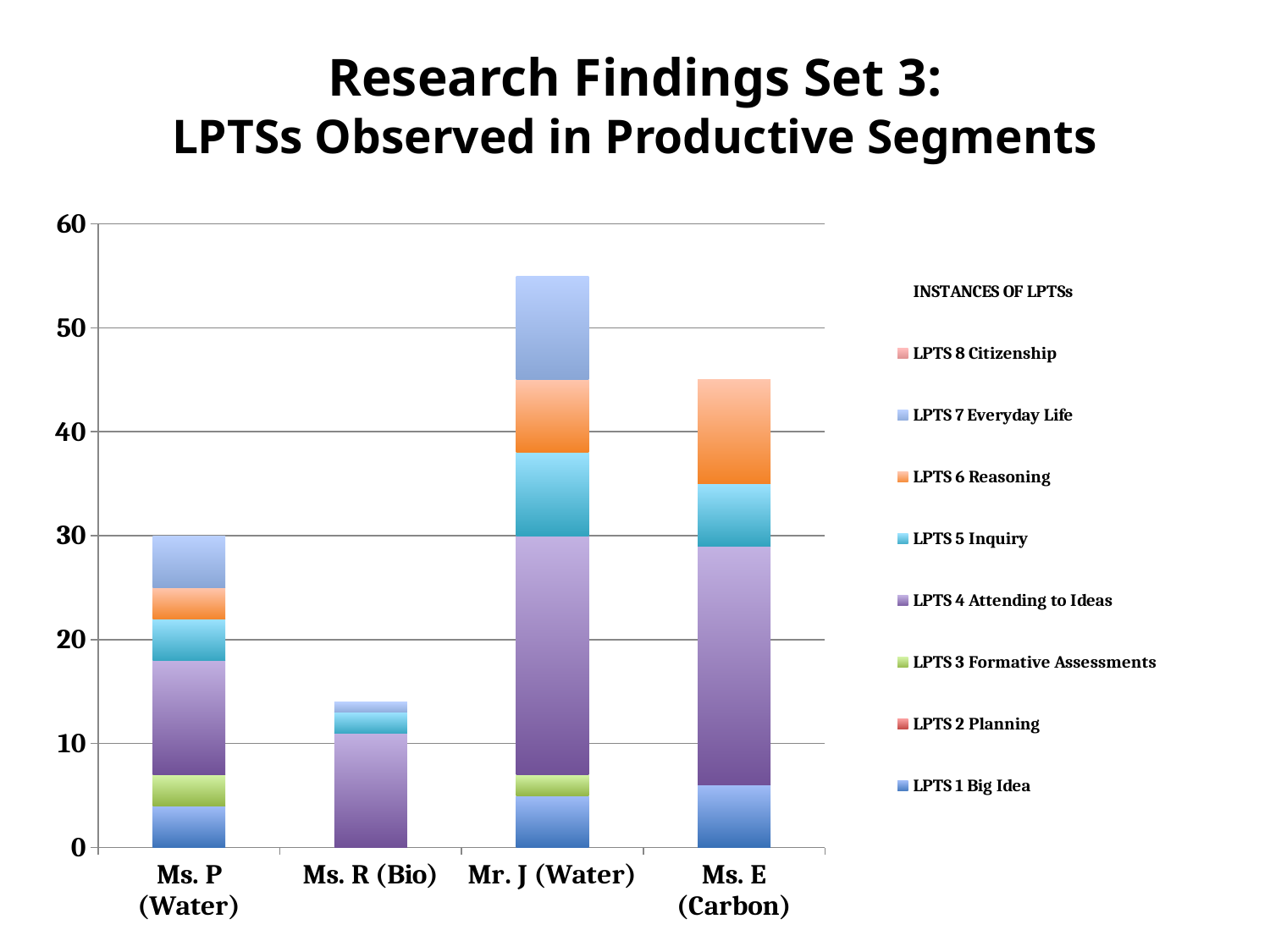
Which LPTS series appears at the bottom of each stacked bar? LPTS 1 Big Idea Is the total for Ms. R (Bio) greater or less than 20? less Which teacher has the shortest stacked bar? Ms. R (Bio) What kind of chart is shown on the slide? Stacked bar chart How many LPTS series does the legend list? 8 Is the total for Ms. E (Carbon) greater or less than 40? greater What is the total height of the stacked bar for Ms. P (Water)? 30 Is the total for Mr. J (Water) greater or less than 50? greater Which teacher has the tallest stacked bar? Mr. J (Water) What is the title shown at the top of the legend? INSTANCES OF LPTSs How many teachers (categories) are shown on the x axis? 4 Which has the larger total, Ms. P (Water) or Ms. E (Carbon)? Ms. E (Carbon)